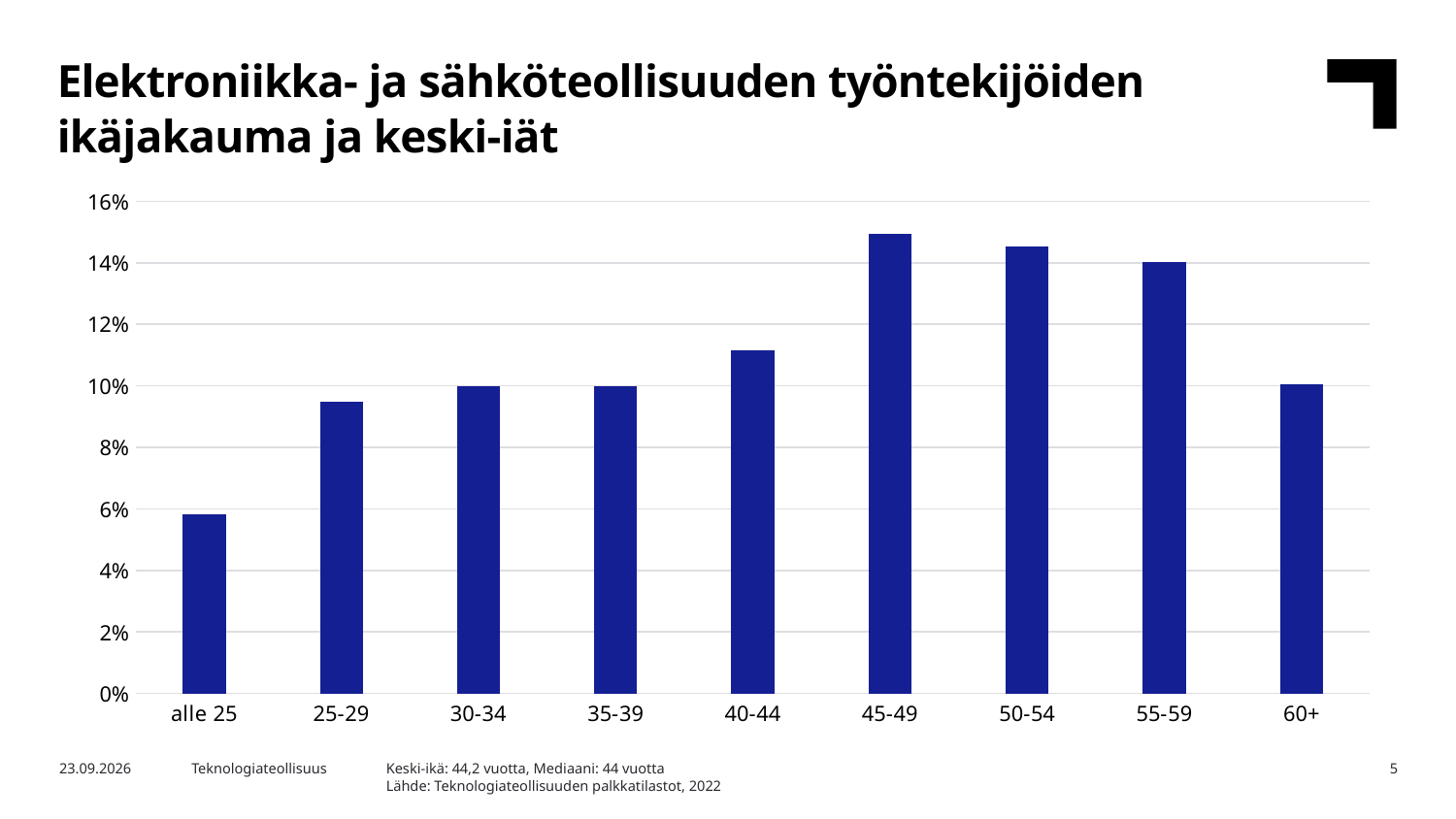
What kind of chart is shown on the slide? bar chart Do the values rise or fall from alle 25 to 45-49? rise Is the value for 25-29 greater or less than 10%? less Is the value for 45-49 greater or less than 14%? greater According to the footer, what is the median age (Mediaani)? 44 vuotta Which age group has the highest share? 45-49 How many age groups are shown on the x axis? 9 Which age group has the lowest share? alle 25 Is the value for alle 25 greater or less than 8%? less Which has a larger share, 40-44 or 25-29? 40-44